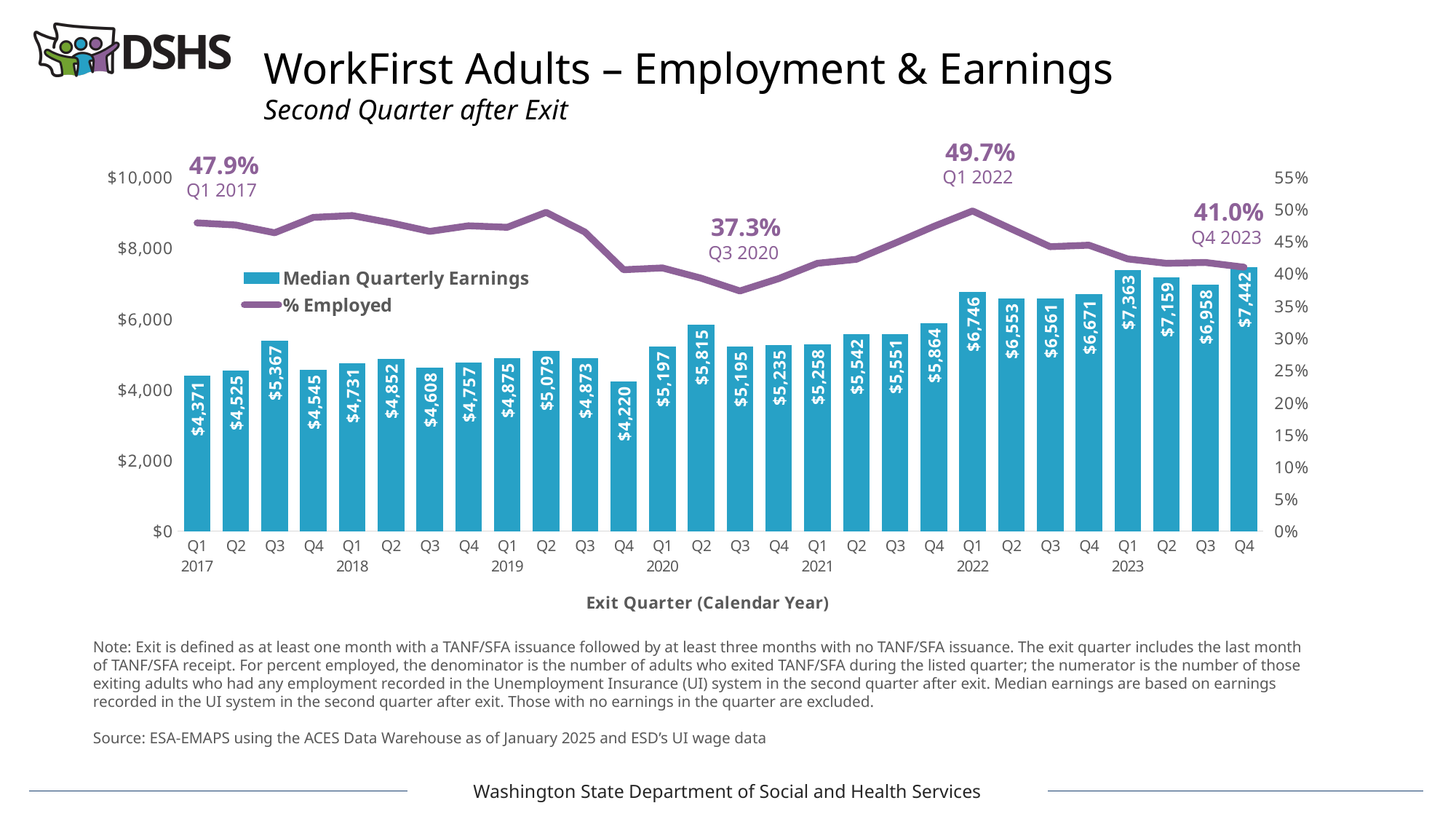
Which has higher Median Quarterly Earnings, Q3 2017 or Q4 2017? Q3 2017 How many series does the legend list? 2 What kind of chart is used to show Median Quarterly Earnings? Bar chart What is the difference in Median Quarterly Earnings between Q4 2023 and Q1 2017? $3,071 What is the Median Quarterly Earnings value for Q1 2017? $4,371 Which exit quarter has the highest Median Quarterly Earnings? Q4 2023 What is the Median Quarterly Earnings value for Q2 2020? $5,815 What percent employed is labeled for Q1 2022? 49.7% Which exit quarter has the lowest Median Quarterly Earnings? Q4 2019 Is the % Employed value for Q3 2022 greater or less than 40%? greater What percent employed is labeled for Q3 2020? 37.3% How many exit quarters are shown on the x axis? 28